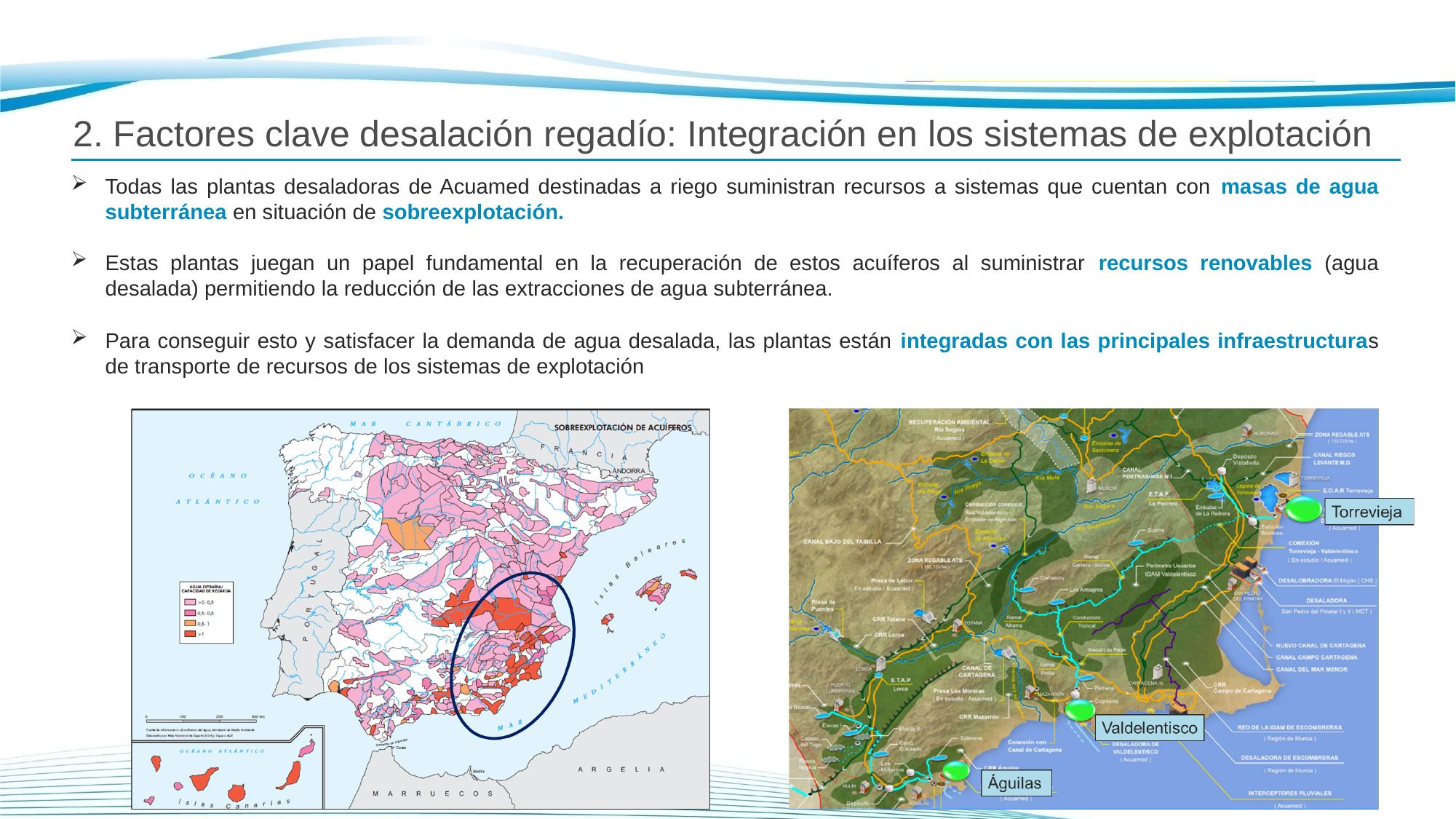
On the left map, what is the lowest value range shown in the legend? >0-0,5 How many value ranges does the legend of the left map list? 4 Which three plants are labelled with green markers on the right map? Torrevieja, Valdelentisco, Águilas What is the title printed in the top-right corner of the left map? SOBREEXPLOTACIÓN DE ACUÍFEROS On the left map, what is the highest value range shown in the legend? >1 How many desalination plants are highlighted with green markers and name labels on the right map? 3